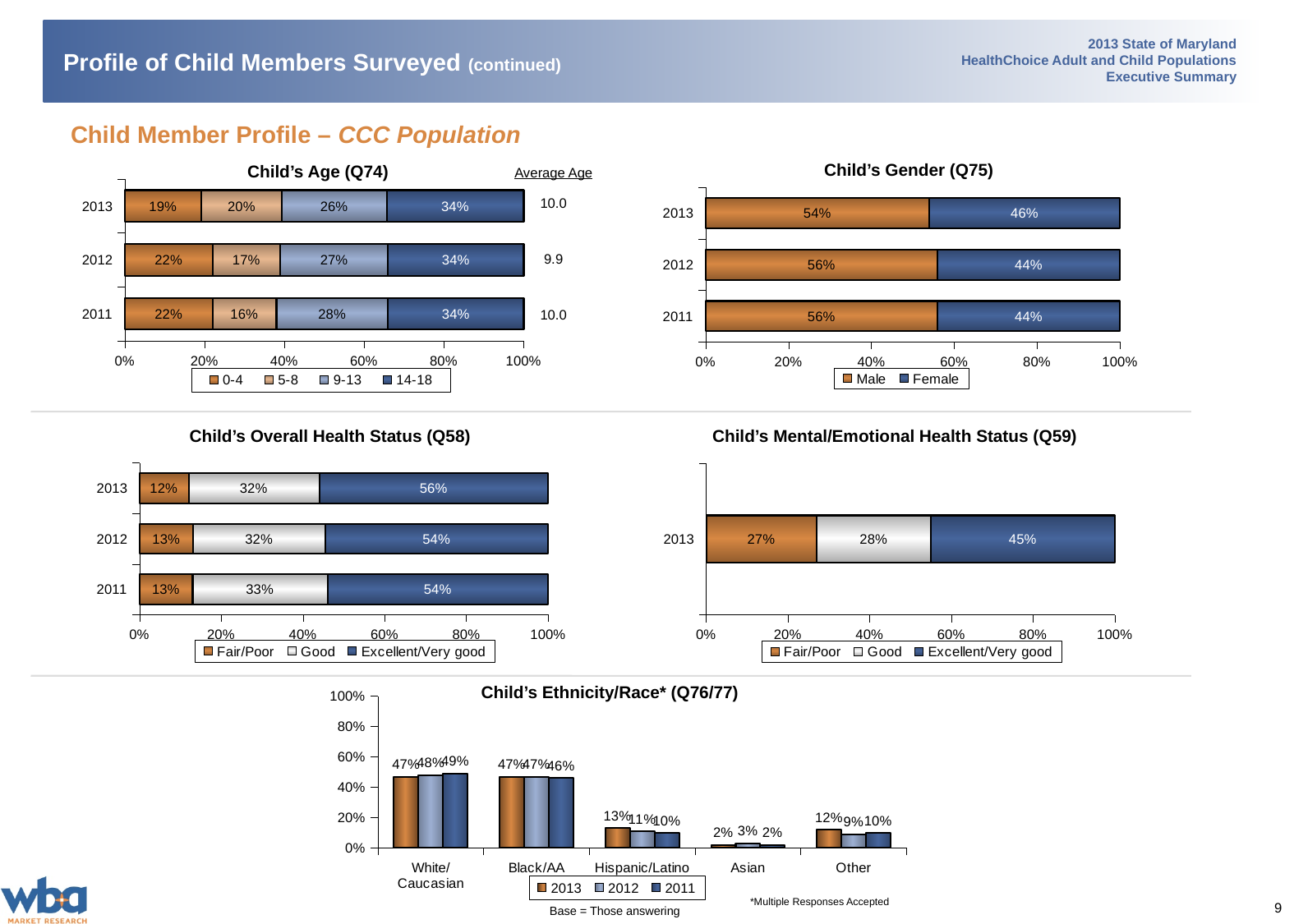
In the Child's Age (Q74) chart, what percentage of children surveyed in 2013 were aged 14-18? 34% In the Child's Ethnicity/Race (Q76/77) chart, how many ethnicity/race categories are shown on the x axis? 5 In the Child's Age (Q74) chart, how many series does the legend list? 4 In the Child's Overall Health Status (Q58) chart, what percentage of children in 2013 were rated Excellent/Very good? 56% In the Child's Overall Health Status (Q58) chart, what is the difference between the Excellent/Very good share in 2013 and in 2012? 2% In the Child's Mental/Emotional Health Status (Q59) chart, what percentage of children in 2013 were rated Fair/Poor? 27% In the Child's Age (Q74) chart, what is the difference between the 0-4 share in 2012 and the 0-4 share in 2013? 3% In the Child's Mental/Emotional Health Status (Q59) chart, which category has the highest value for 2013? Excellent/Very good In the Child's Gender (Q75) chart, which is larger for 2012: the Male share or the Female share? Male In the Child's Ethnicity/Race (Q76/77) chart, which ethnicity/race category has the lowest value in 2012? Asian In the Child's Gender (Q75) chart, what percentage of children surveyed in 2013 were male? 54% In the Child's Ethnicity/Race (Q76/77) chart, what percentage of children in 2013 were Hispanic/Latino? 13%